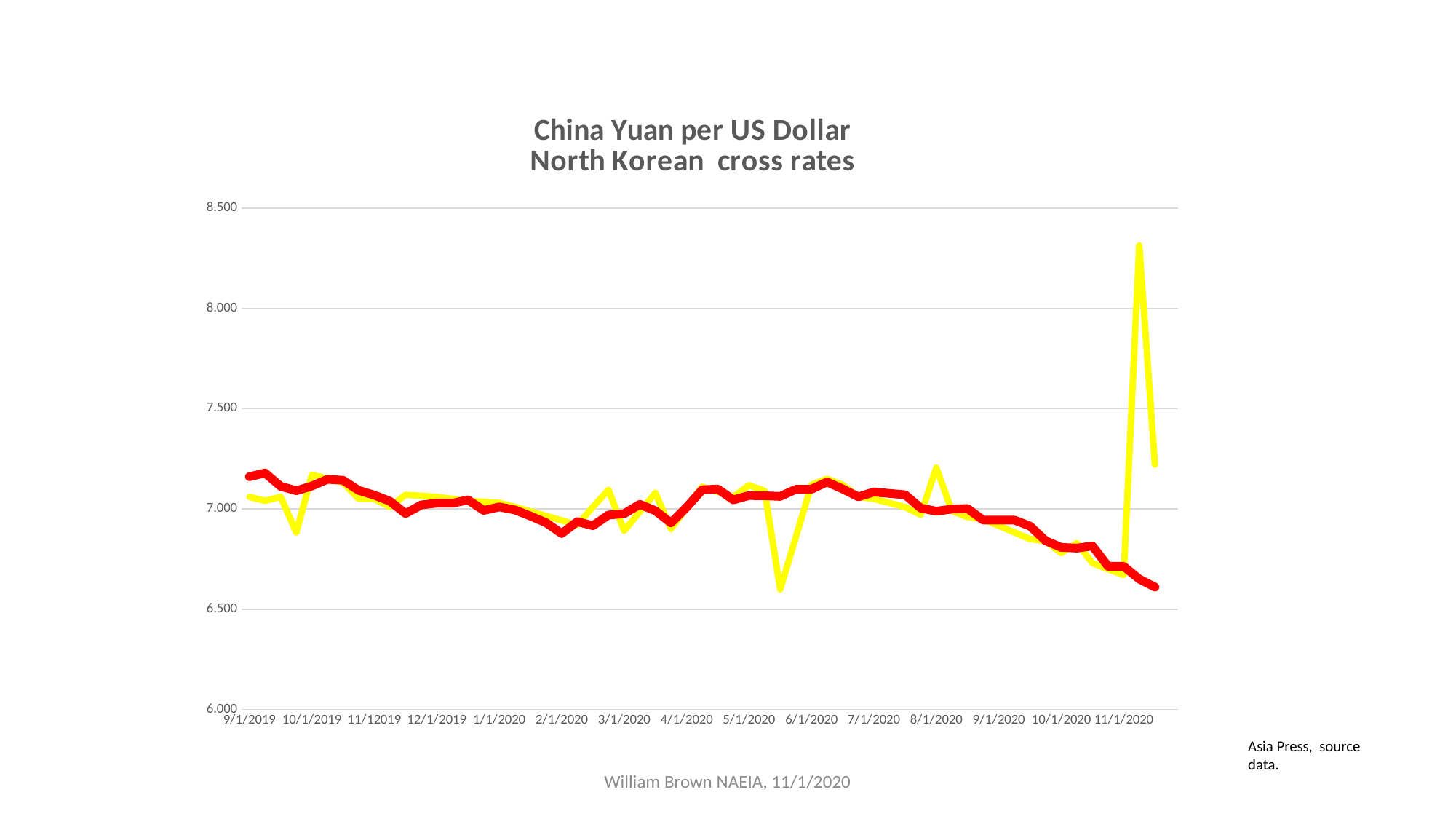
What is the highest value shown on the y axis? 8.500 What is the title of the chart? China Yuan per US Dollar North Korean cross rates What kind of chart is shown on the slide? line chart Does the red line overall rise or fall from 9/1/2019 to the end of the chart? fall How many date labels are shown on the x axis? 15 Near which x-axis date does the yellow line reach its highest point? 11/1/2020 Is the dip of the yellow line between 5/1/2020 and 6/1/2020 greater or less than 7.000? less What is the lowest value shown on the y axis? 6.000 Is the peak of the yellow line near 11/1/2020 greater or less than 8.000? greater Is the value of the red line at 9/1/2019 greater or less than 7.000? greater How many lines are plotted on the chart? 2